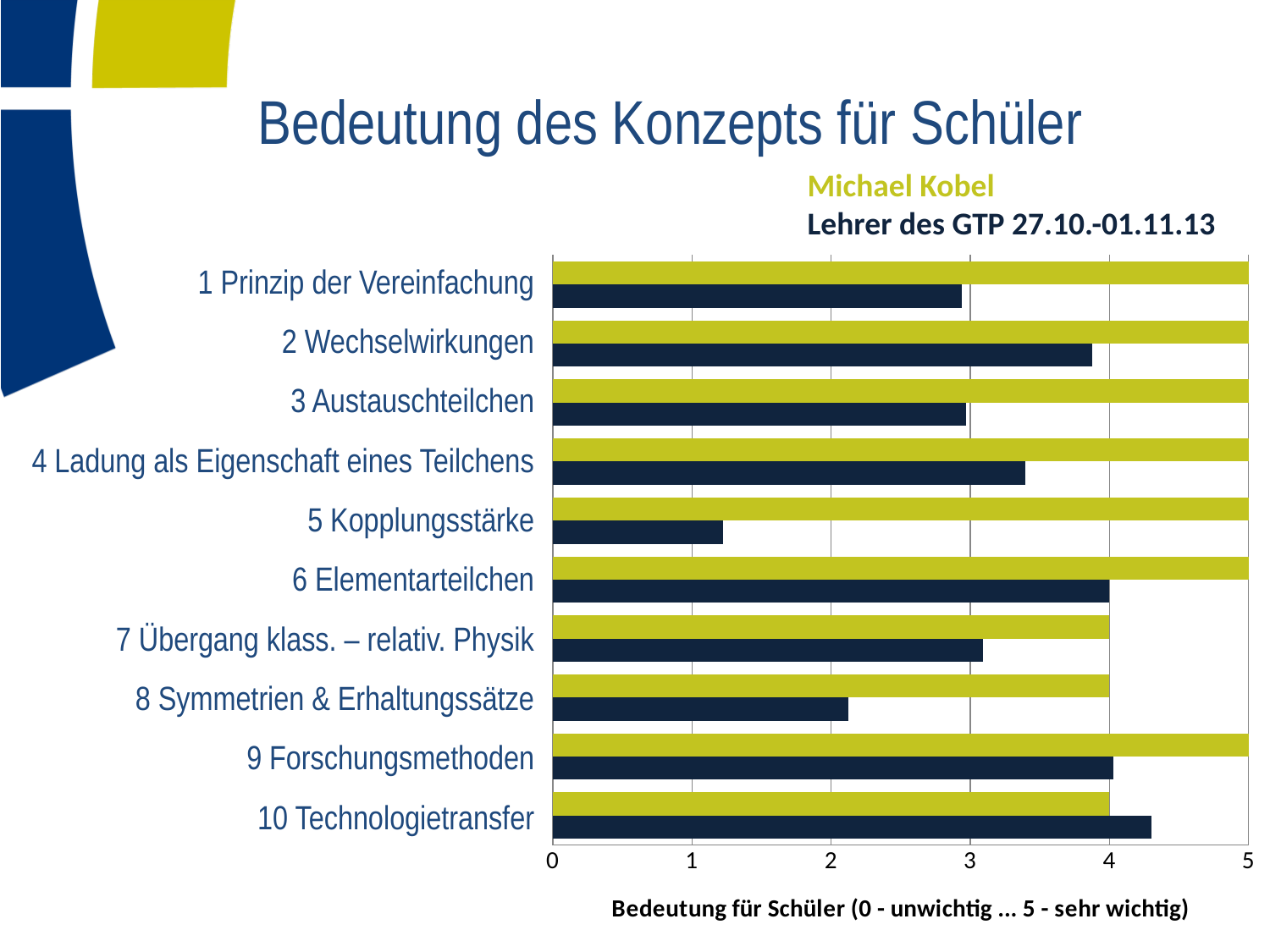
How many series does the chart legend list? 2 How many concepts (categories) are listed on the chart? 10 What value does Michael Kobel give for '7 Übergang klass. – relativ. Physik'? 4 For the series 'Lehrer des GTP 27.10.-01.11.13', which is larger: the value for '2 Wechselwirkungen' or for '8 Symmetrien & Erhaltungssätze'? 2 Wechselwirkungen What kind of chart is shown on the slide? bar chart Which concept has the lowest value for the series 'Lehrer des GTP 27.10.-01.11.13'? 5 Kopplungsstärke Is the value of 'Lehrer des GTP 27.10.-01.11.13' for '10 Technologietransfer' greater or less than 4? greater What value does Michael Kobel give for '1 Prinzip der Vereinfachung'? 5 Is the value of 'Lehrer des GTP 27.10.-01.11.13' for '5 Kopplungsstärke' greater or less than 2? less What is the title of the horizontal axis of the chart? Bedeutung für Schüler (0 - unwichtig ... 5 - sehr wichtig) Is the value of 'Lehrer des GTP 27.10.-01.11.13' for '8 Symmetrien & Erhaltungssätze' greater or less than 3? less Which concept has the highest value for the series 'Lehrer des GTP 27.10.-01.11.13'? 10 Technologietransfer